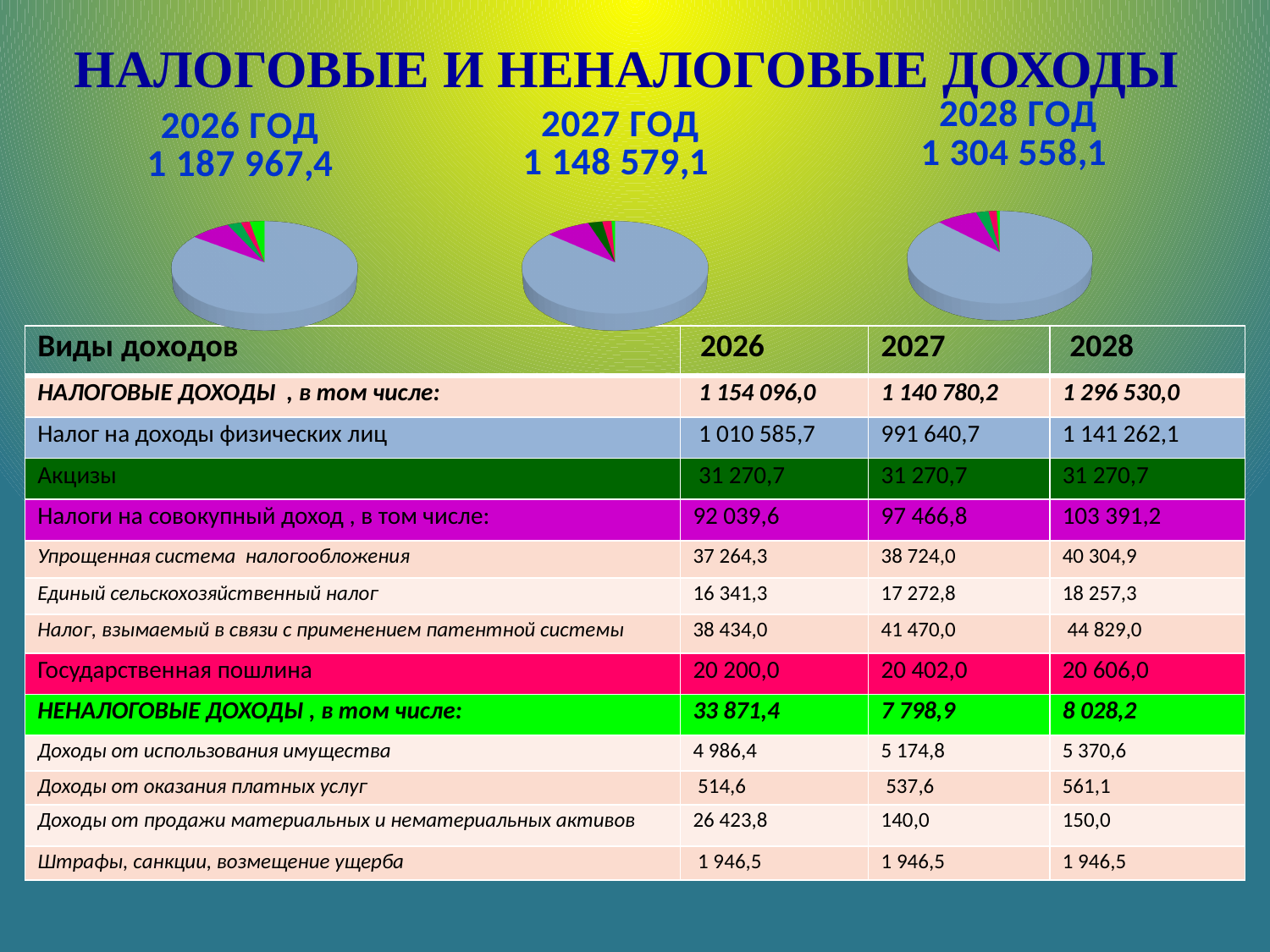
What is the difference between the totals printed above the 2028 год and 2026 год pie charts? 116 590,7 What total is printed above the 2028 год pie chart? 1 304 558,1 Which year's pie chart has the largest total printed above it? 2028 год What kind of charts are shown on the slide? Pie charts How many pie charts are on the slide? 3 What total is printed above the 2027 год pie chart? 1 148 579,1 Which year's pie chart has the smallest total printed above it? 2027 год What is the title of the slide above the pie charts? НАЛОГОВЫЕ И НЕНАЛОГОВЫЕ ДОХОДЫ What total is printed above the 2026 год pie chart? 1 187 967,4 In the 2028 год pie chart, which colour is the largest slice? Light blue What is the difference between the totals printed above the 2026 год and 2027 год pie charts? 39 388,3 Is the total printed above the 2026 год pie chart larger or smaller than the total above the 2027 год pie chart? Larger